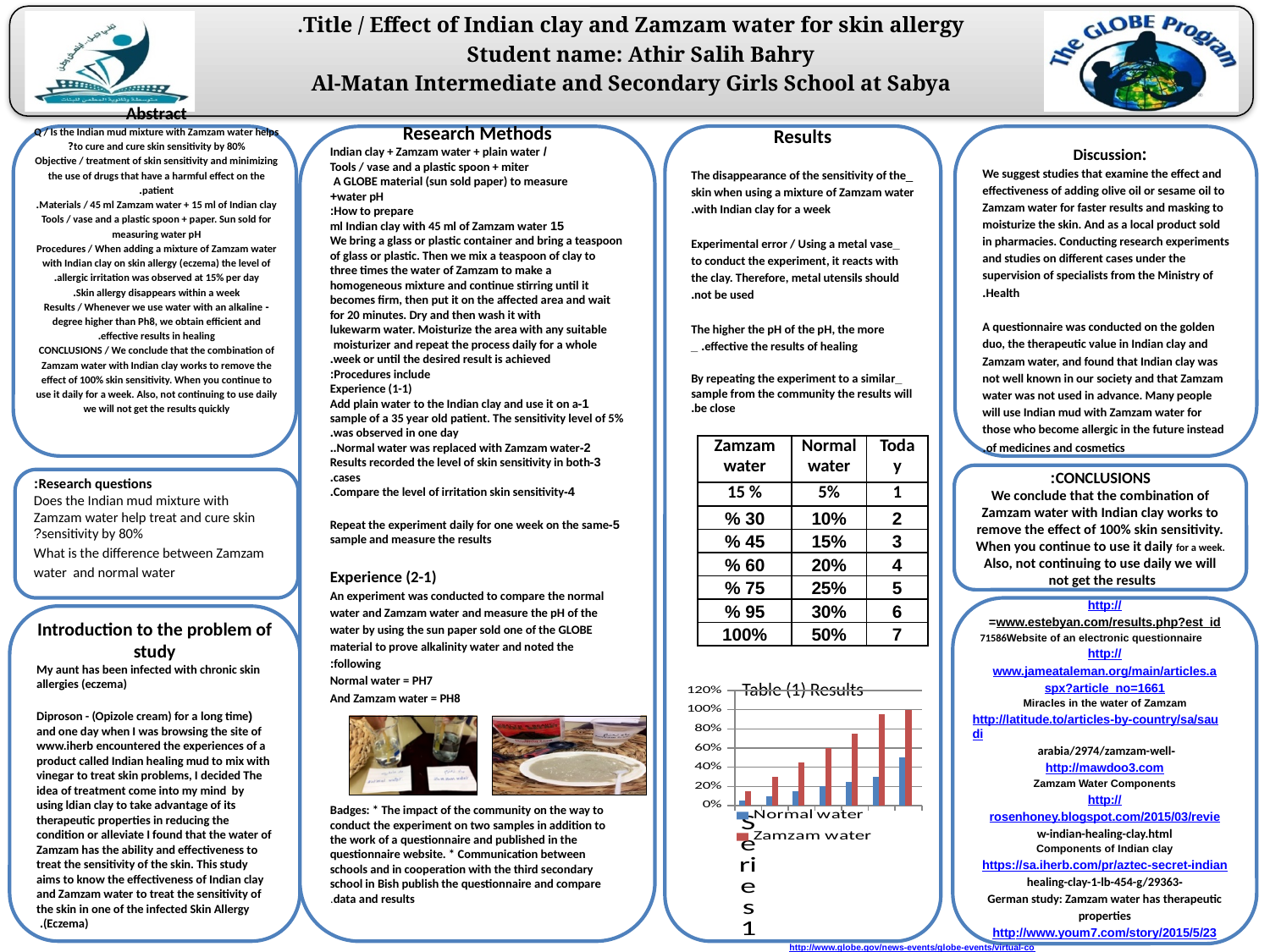
In the 'Table (1) Results' chart, is the Zamzam water value for the last group greater or less than 80%? greater How many series does the legend of the 'Table (1) Results' chart list? 2 In the 'Table (1) Results' chart, which series has the taller bar in the last group: Normal water or Zamzam water? Zamzam water What is the title of the chart in the Results section? Table (1) Results In the 'Table (1) Results' chart, is the Zamzam water value for the first group greater or less than 20%? less In the 'Table (1) Results' chart, which series reaches the highest value overall? Zamzam water In the 'Table (1) Results' chart, is the Normal water value for the last group greater or less than 60%? less In the 'Table (1) Results' chart, do the Normal water values rise or fall from left to right? rise What kind of chart is shown at the bottom of the Results section? bar chart Which two series are listed in the legend of the 'Table (1) Results' chart? Normal water and Zamzam water How many groups of bars are plotted along the x axis of the 'Table (1) Results' chart? 7 In the 'Table (1) Results' chart, do the Zamzam water values rise or fall from left to right? rise